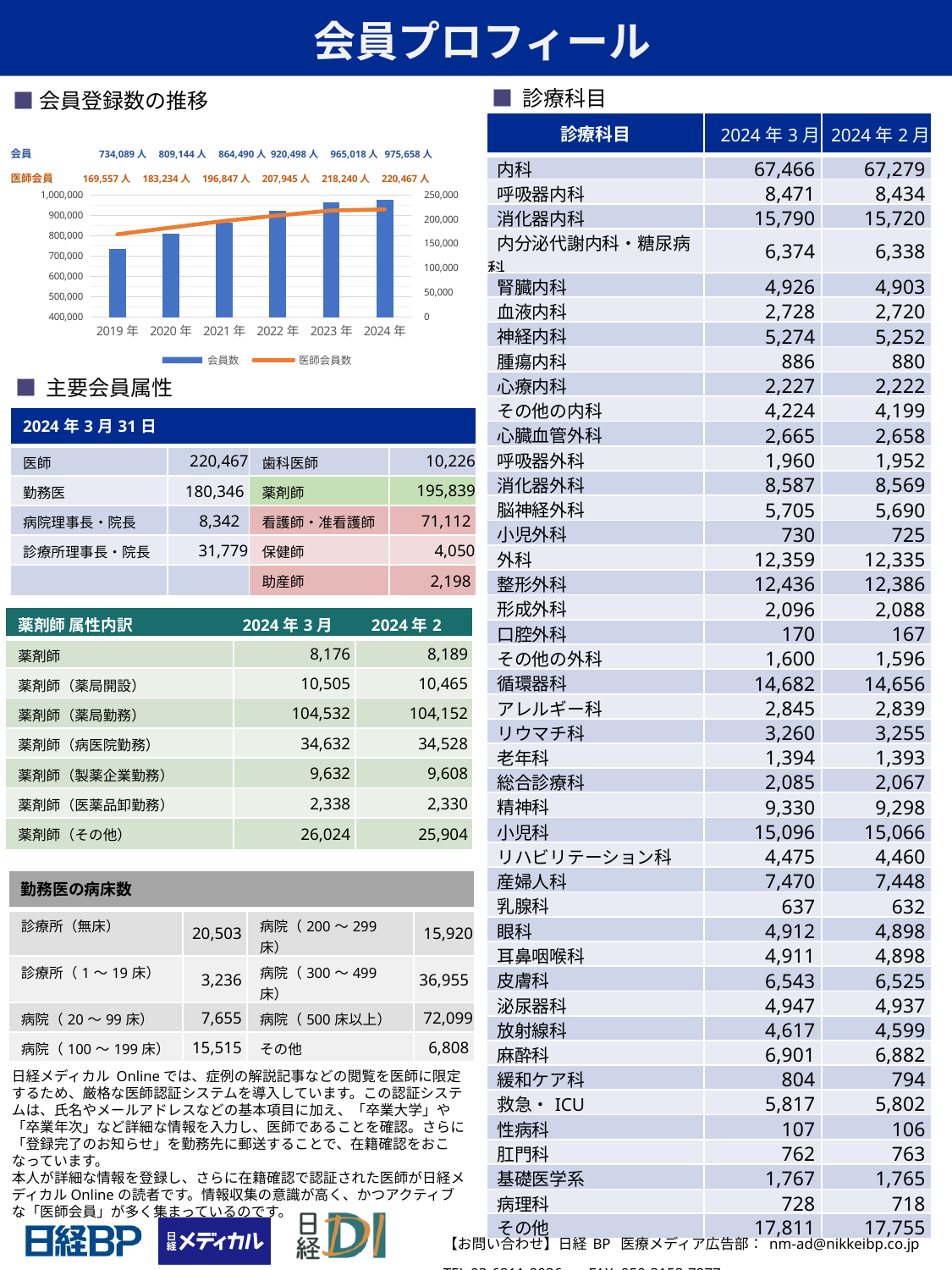
In the 会員登録数の推移 chart, what is the difference between the 会員 values for 2024年 and 2023年? 10,640人 In the 会員登録数の推移 chart, which year has the highest 会員 value? 2024年 In the 会員登録数の推移 chart, which year has the lowest 医師会員 value? 2019年 In the 会員登録数の推移 chart, what is the 会員 value for 2022年? 920,498人 In the 会員登録数の推移 chart, how many series does the legend list? 2 In the 会員登録数の推移 chart, do the 会員数 values rise or fall from 2019年 to 2024年? rise In the 会員登録数の推移 chart, which is larger: the 医師会員 value for 2020年 or for 2022年? 2022年 In the 会員登録数の推移 chart, what is the 医師会員 value for 2021年? 196,847人 In the 会員登録数の推移 chart, how many years are shown on the x axis? 6 In the 会員登録数の推移 chart, what is the 会員 value for 2019年? 734,089人 In the 会員登録数の推移 chart, which series is drawn as a line rather than bars? 医師会員数 In the 会員登録数の推移 chart, what is the 医師会員 value for 2024年? 220,467人